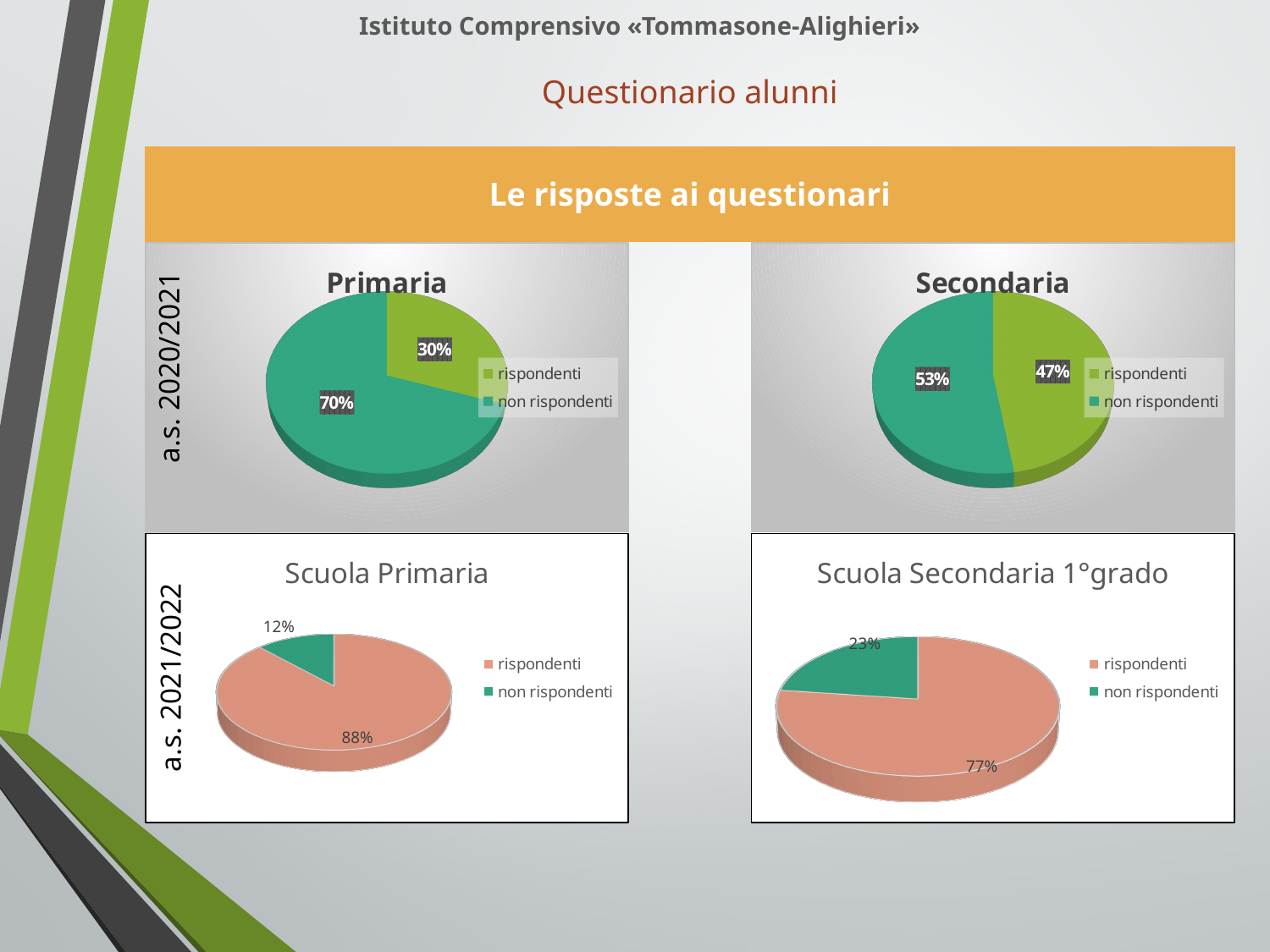
In the 'Primaria' chart, what is the difference between 'non rispondenti' and 'rispondenti'? 40% In the 'Secondaria' chart, what is the value for 'rispondenti'? 47% In the 'Scuola Primaria' chart, what is the value for 'non rispondenti'? 12% In the 'Primaria' chart, what is the value for 'non rispondenti'? 70% In the 'Scuola Secondaria 1°grado' chart, what is the value for 'rispondenti'? 77% In the 'Scuola Secondaria 1°grado' chart, what is the value for 'non rispondenti'? 23% How many entries does the legend of the 'Scuola Secondaria 1°grado' chart list? 2 What kind of chart is the 'Scuola Primaria' chart? Pie chart In the 'Secondaria' chart, which slice is larger, 'rispondenti' or 'non rispondenti'? non rispondenti In the 'Scuola Primaria' chart, what is the value for 'rispondenti'? 88% In the 'Secondaria' chart, what is the value for 'non rispondenti'? 53% In the 'Primaria' chart, what share of the pie is 'rispondenti'? 30%